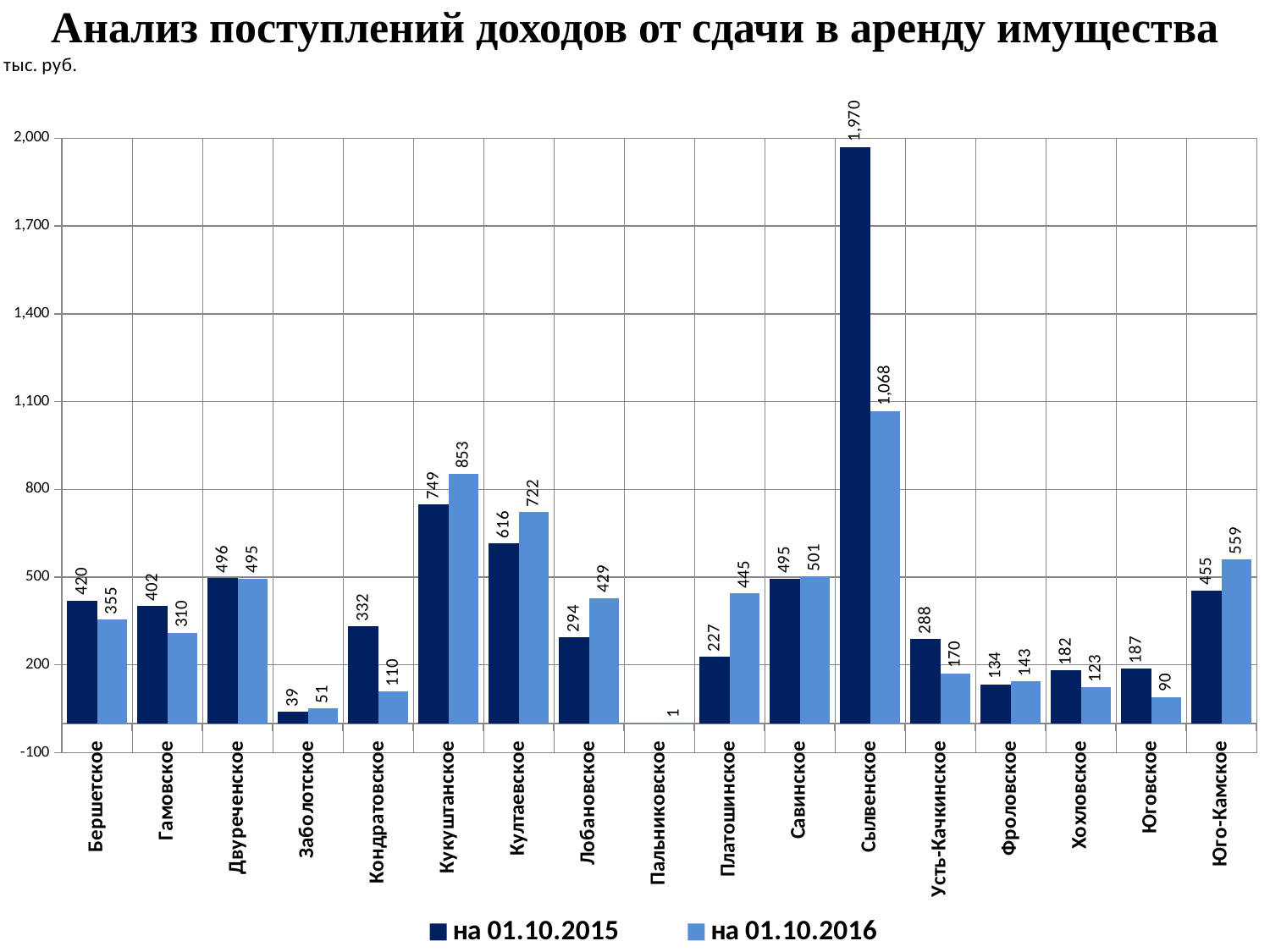
What is the value for Кондратовское на 01.10.2016? 110 What is the value for Сылвенское на 01.10.2015? 1,970 Which is larger for Платошинское: the value на 01.10.2015 or на 01.10.2016? на 01.10.2016 How many categories are shown on the x axis? 17 What type of chart is shown on the slide? bar chart What is the value for Кукуштанское на 01.10.2016? 853 Which category has the lowest value на 01.10.2015 among those with a printed label? Заболотское Which category has the highest value на 01.10.2016? Сылвенское What unit is indicated in the top-left corner of the chart? тыс. руб. Is the value for Култаевское на 01.10.2016 greater or less than 500? greater How many series does the legend list? 2 What is the difference between the 01.10.2015 and 01.10.2016 values for Сылвенское? 902